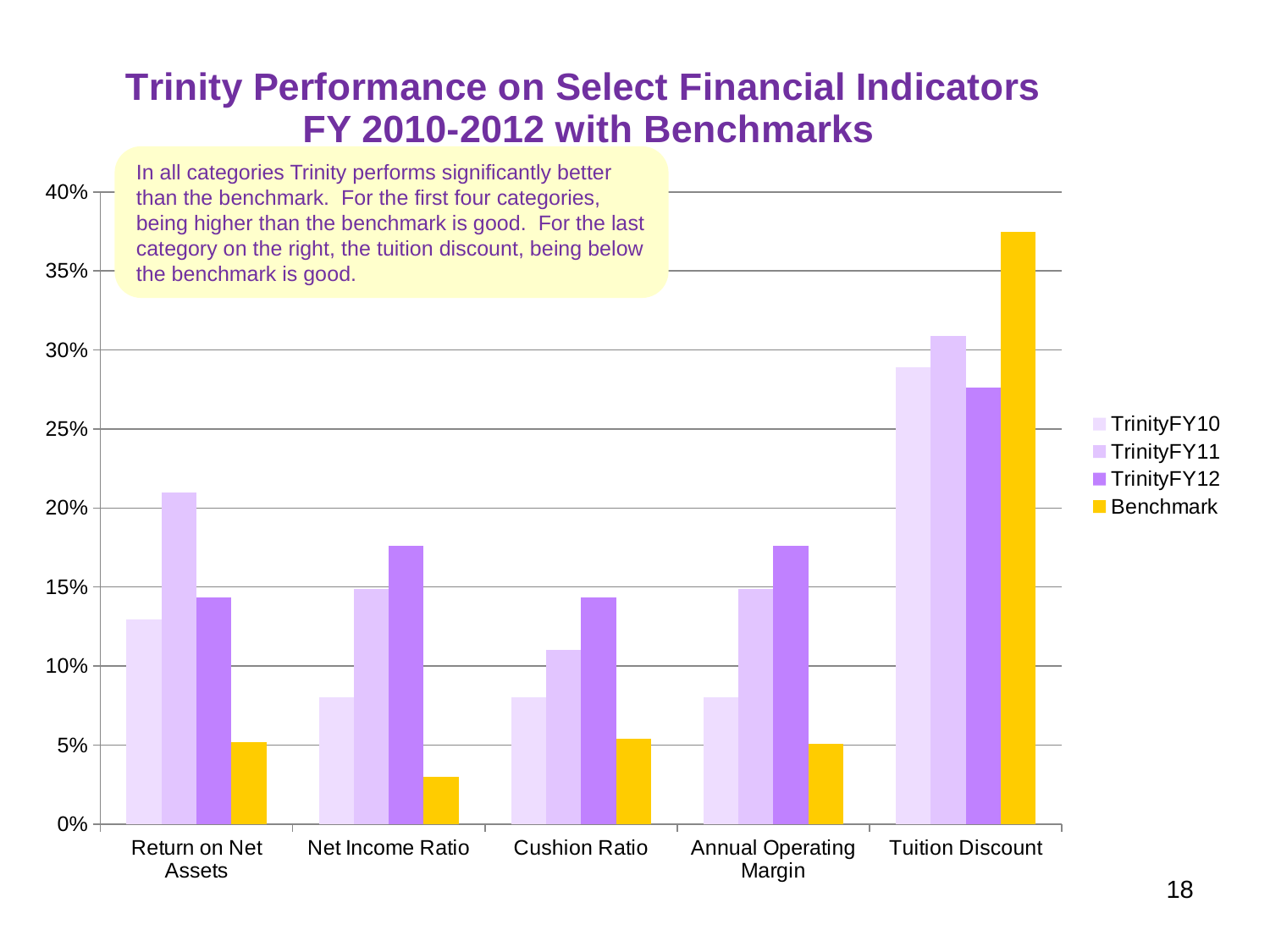
Is the TrinityFY12 value for Net Income Ratio greater or less than 15%? greater How many categories are shown along the x axis? 5 For Return on Net Assets, which is larger: TrinityFY11 or TrinityFY12? TrinityFY11 Which series has the highest value for Return on Net Assets? TrinityFY11 For Tuition Discount, which is larger: TrinityFY11 or Benchmark? Benchmark Which category has the highest Benchmark value? Tuition Discount Which category has the lowest Benchmark value? Net Income Ratio How many series does the legend list? 4 Is the Benchmark value for Tuition Discount greater or less than 35%? greater Is the TrinityFY11 value for Return on Net Assets greater or less than 20%? greater What kind of chart is shown on the slide? Bar chart What colour represents the Benchmark series in the legend? Yellow